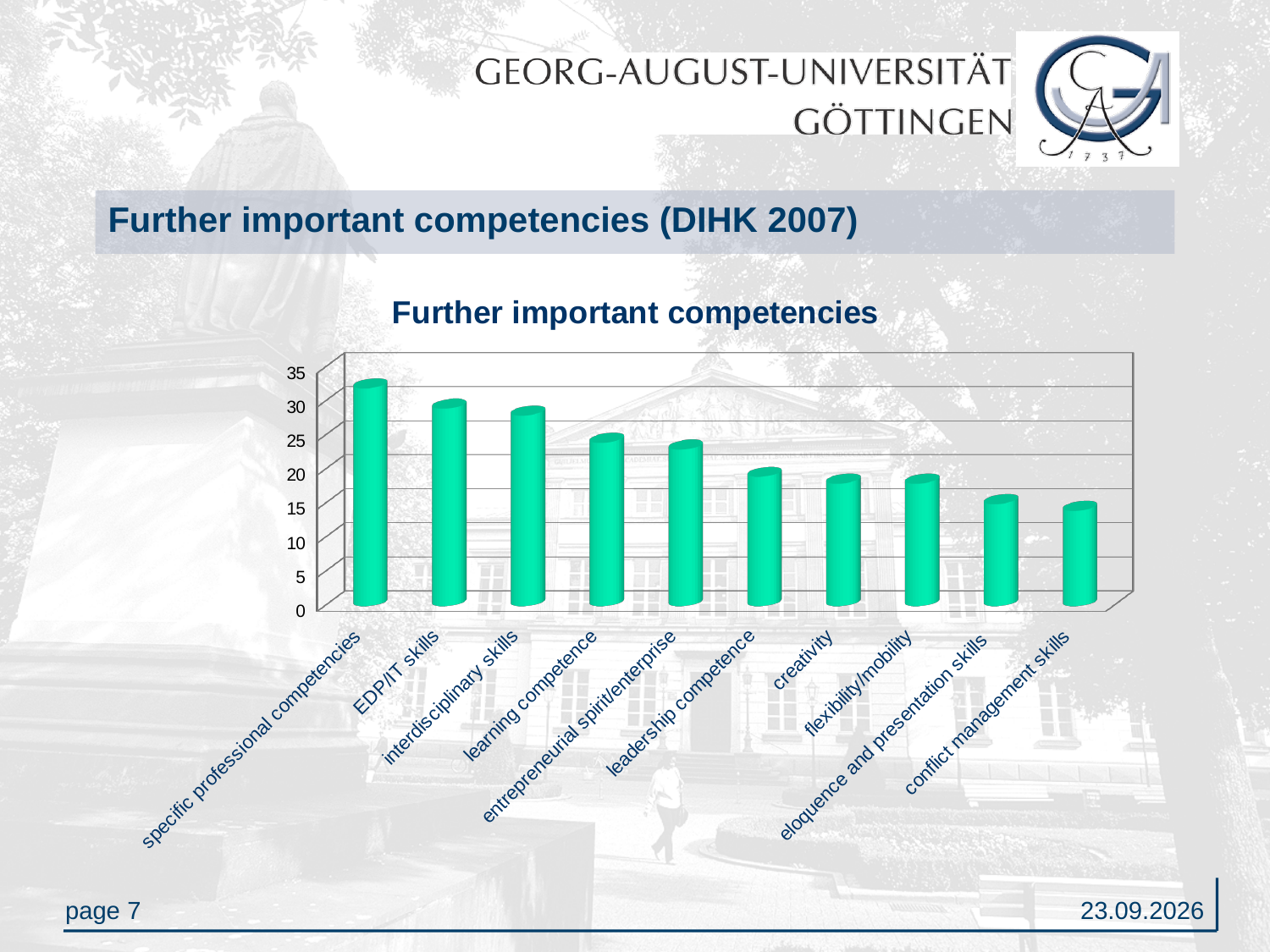
Which category has the highest value in the chart? specific professional competencies What kind of chart is shown on the slide? bar chart Which is larger, the value for learning competence or the value for leadership competence? learning competence Is the value for conflict management skills greater or less than 20? less Is the value for specific professional competencies greater or less than 30? greater What is the title of the chart? Further important competencies Is the value for EDP/IT skills greater or less than 25? greater Which is larger, the value for specific professional competencies or the value for conflict management skills? specific professional competencies Do the values rise or fall from left to right along the x axis? fall Which category has the lowest value in the chart? conflict management skills How many categories are plotted in the chart? 10